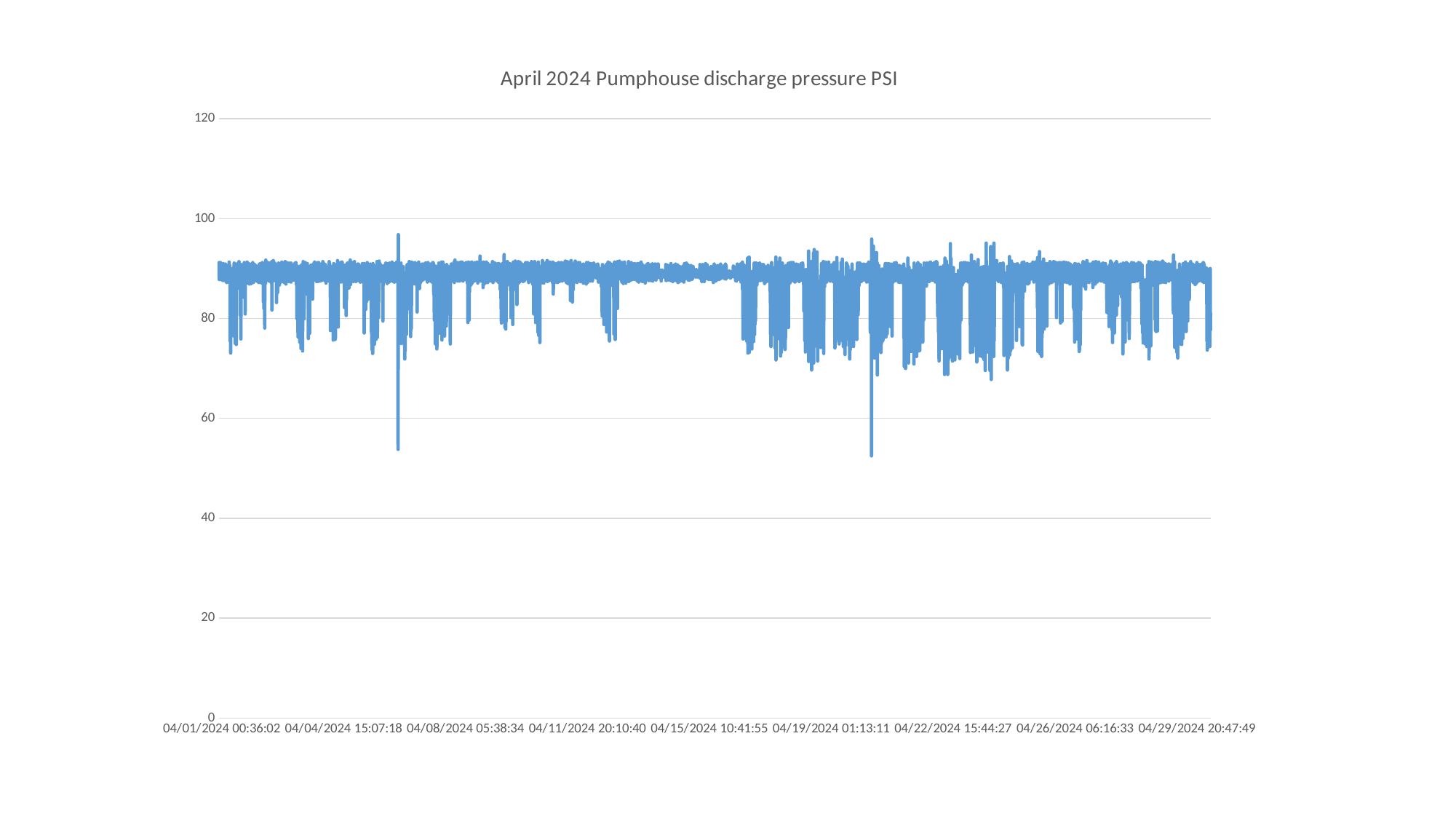
Is the lowest pressure value plotted on the chart greater or less than 60? less Is the lowest pressure value plotted on the chart greater or less than 40? greater Is the highest pressure value plotted on the chart greater or less than 100? less What kind of chart is shown on the slide? line chart What is the first timestamp label on the horizontal axis? 04/01/2024 00:36:02 What is the title of the chart? April 2024 Pumphouse discharge pressure PSI Does the pressure line show a clear overall rise or fall across the month, or does it stay roughly level? roughly level What is the highest value shown on the vertical axis? 120 How many timestamp labels are shown along the horizontal axis? 9 What is the last timestamp label on the horizontal axis? 04/29/2024 20:47:49